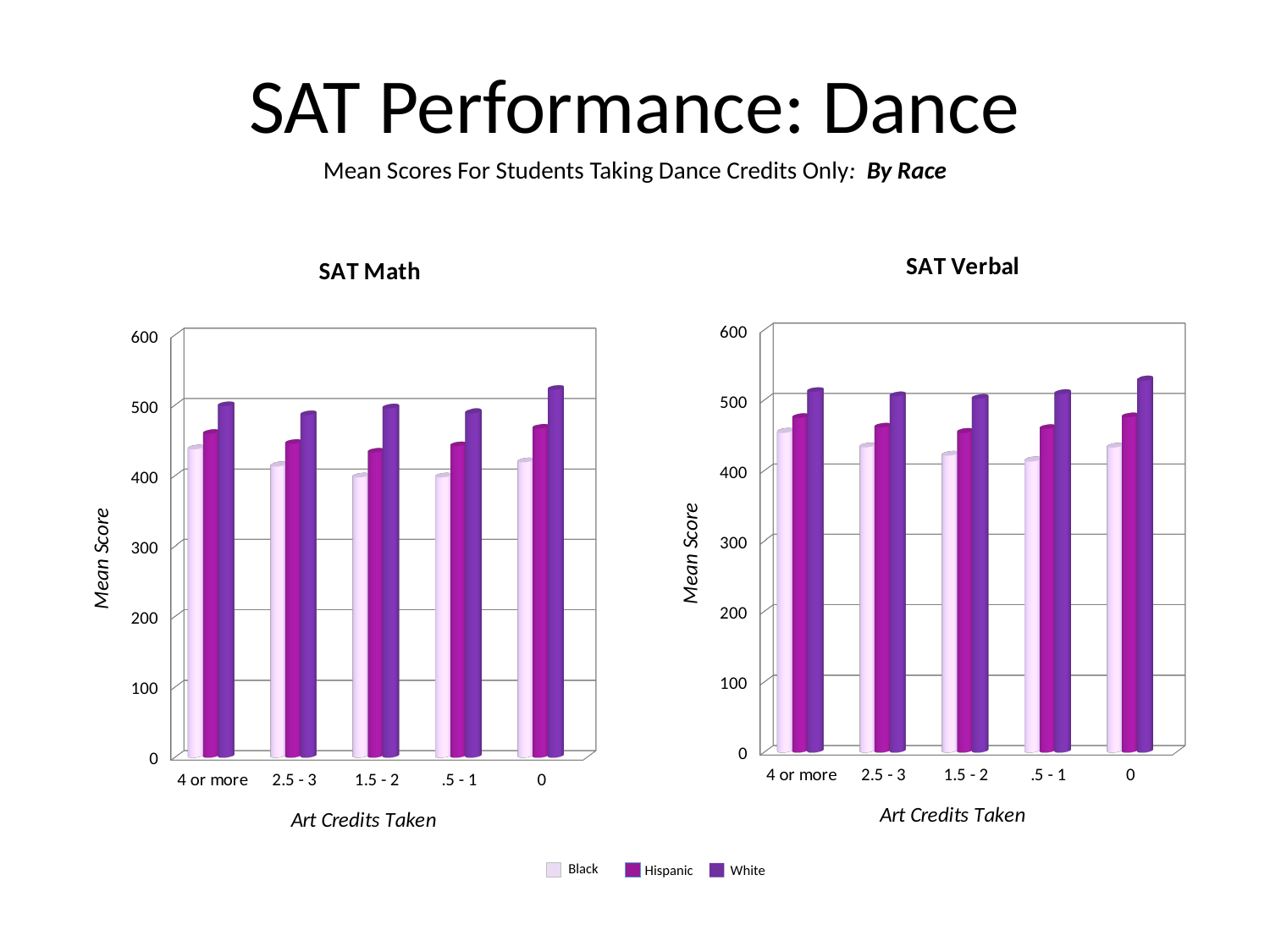
In the SAT Verbal chart, which series has the highest bar at 0 art credits? White In the SAT Math chart, is the value for Hispanic at 1.5 - 2 art credits greater or less than 500? less What is the y-axis title of the SAT Verbal chart? Mean Score In the SAT Math chart, is the value for Black at 4 or more art credits greater or less than 400? greater In the SAT Math chart, which is larger at 4 or more art credits, the White bar or the Black bar? White In the SAT Verbal chart, which series has the lowest bar at .5 - 1 art credits? Black How many art-credit categories are shown on the x axis of the SAT Verbal chart? 5 How many series does the legend list? 3 In the SAT Math chart, is the value for White at 0 art credits greater or less than 500? greater What kind of chart is the SAT Math chart? bar chart